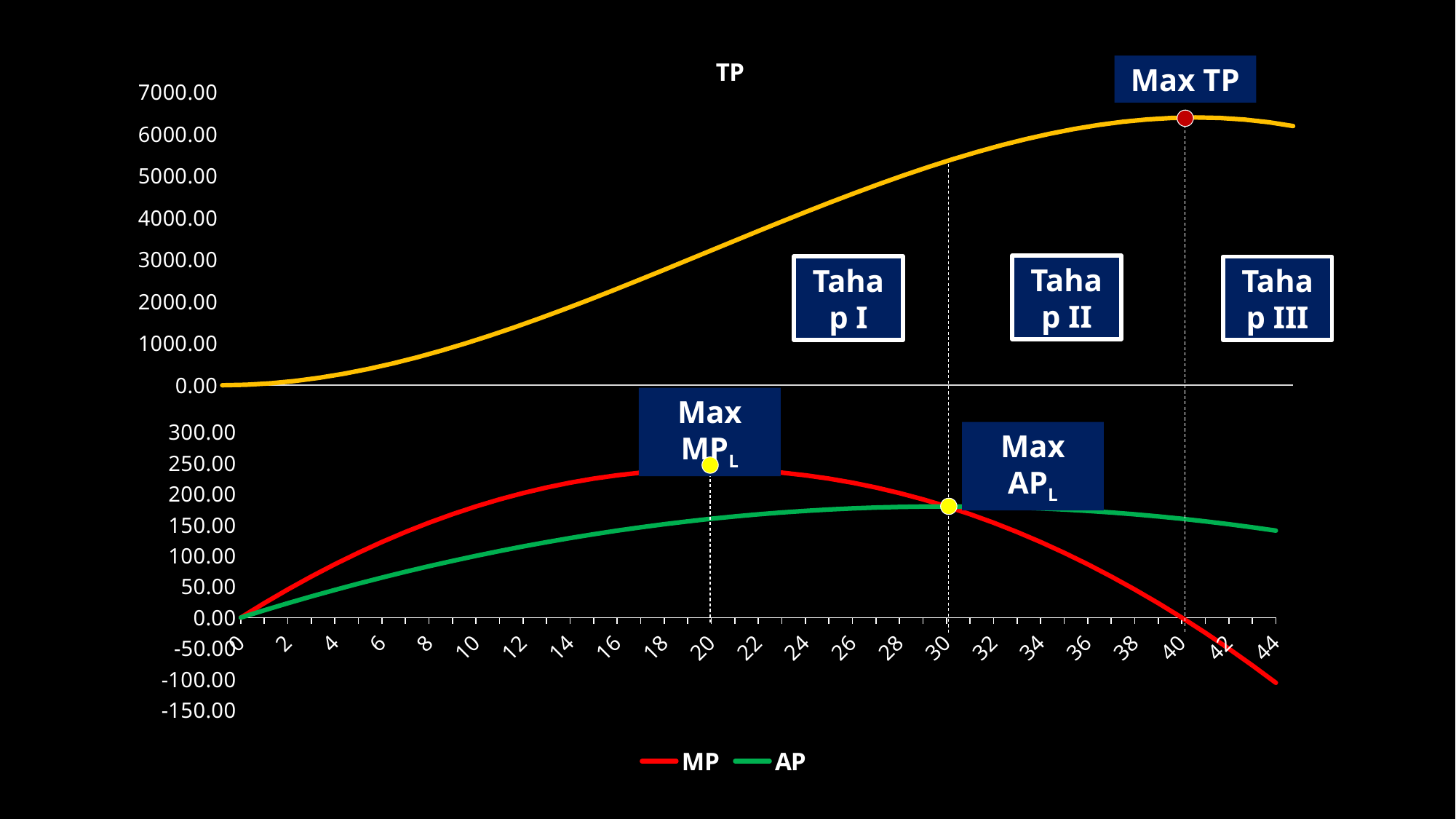
What kind of chart is the top chart titled TP? line chart In the top chart, at which x value does the TP curve reach its maximum (marked Max TP)? 40 In the bottom chart, at x = 40, which series has the larger value, MP or AP? AP In the bottom chart, what are the two series named in the legend? MP and AP In the bottom chart, is the value of MP at x = 44 greater or less than 0? less In the bottom chart, at which x value does the AP line reach its maximum (marked Max AP)? 30 In the top chart, is the value of TP at x = 10 greater or less than 2000? less In the top chart, is the value of TP at x = 40 greater or less than 6000? greater In the bottom chart, at x = 10, which series has the larger value, MP or AP? MP In the bottom chart, how many series does the legend list? 2 In the bottom chart, at which x value does the MP line reach its maximum (marked Max MP)? 20 In the bottom chart, what colour is the MP line? red